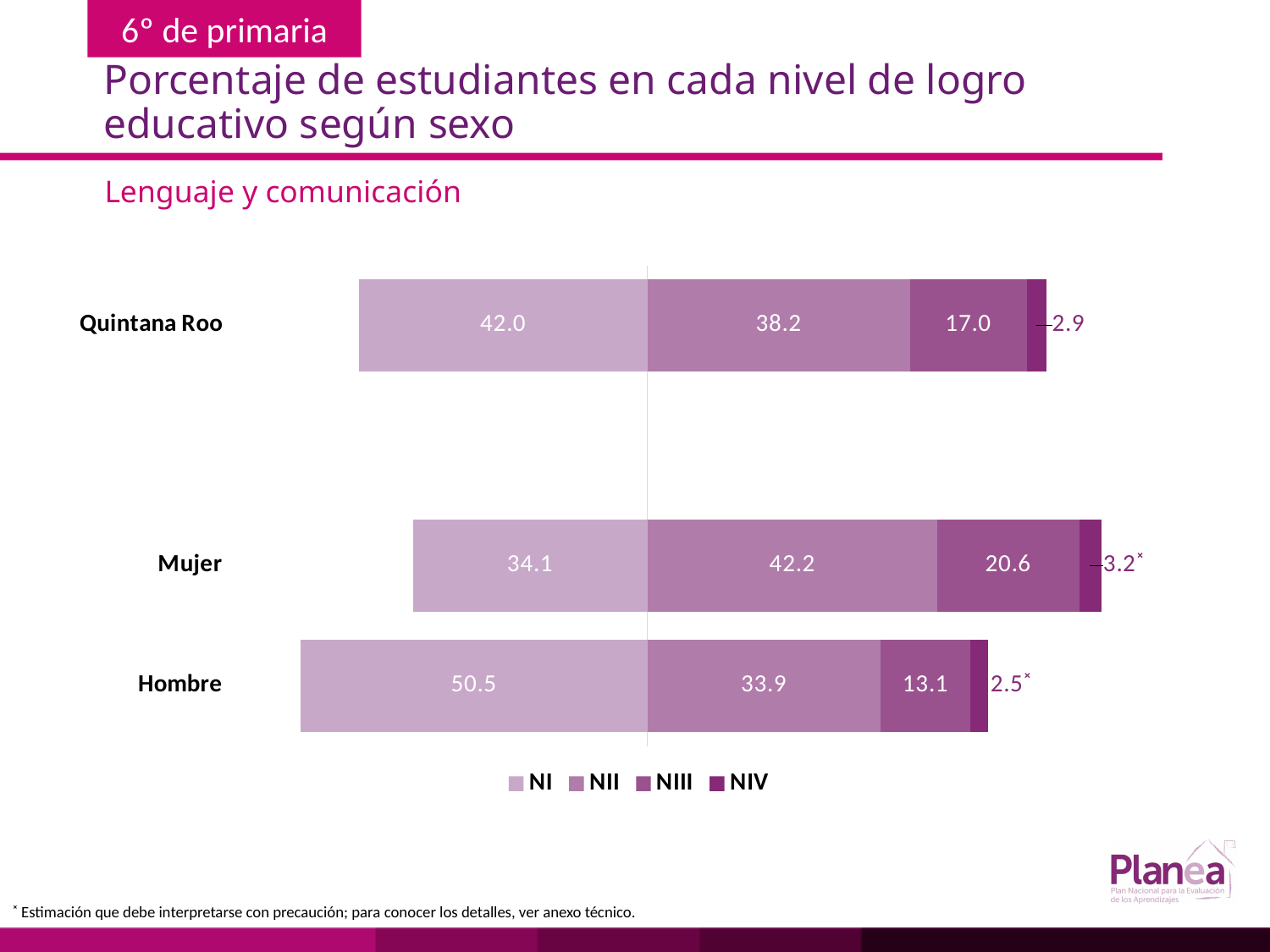
What is the difference between the NI values for Hombre and Mujer? 16.4 What kind of chart is shown on the slide? Stacked bar chart What is the NI value for Hombre? 50.5 Which category has the lowest NIII value? Hombre What is the NIII value for Quintana Roo? 17.0 Which category has the highest NI value? Hombre What is the total of the stacked bar for Hombre? 100.0 Which is larger, the NII value for Quintana Roo or the NII value for Hombre? Quintana Roo What is the NII value for Mujer? 42.2 How many categories are shown on the chart? 3 How many series does the legend list? 4 What is the NIV value for Mujer? 3.2